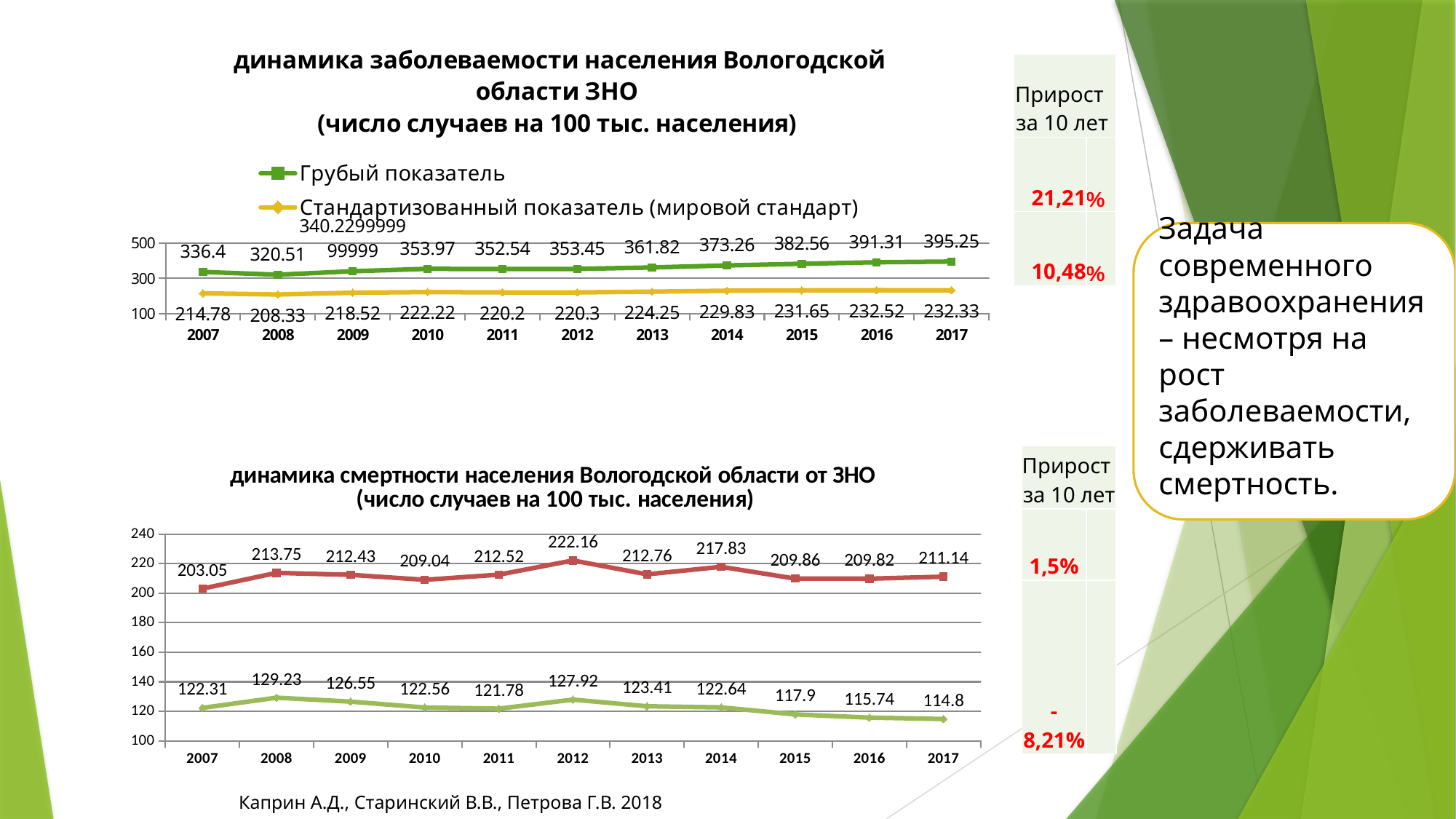
In the top chart (динамика заболеваемости), which year has the lowest value of Грубый показатель? 2008 In the top chart (динамика заболеваемости населения Вологодской области ЗНО), what is the value of Грубый показатель for 2017? 395.25 In the bottom chart (динамика смертности), what is the difference between the upper (red) line values for 2012 and 2007? 19.11 In the top chart (динамика заболеваемости), how many years are shown on the x axis? 11 In the bottom chart (динамика смертности), which year has the lowest value on the lower (green) line? 2017 In the top chart (динамика заболеваемости), what is the value of Стандартизованный показатель (мировой стандарт) for 2007? 214.78 In the bottom chart (динамика смертности), is the value of the lower (green) line for 2017 larger or smaller than its value for 2007? smaller In the bottom chart (динамика смертности), which year has the highest value on the lower (green) line? 2008 What type of chart is the bottom chart (динамика смертности населения Вологодской области от ЗНО)? line chart In the bottom chart (динамика смертности), what is the value of the upper (red) line for 2012? 222.16 In the top chart (динамика заболеваемости), how many series does the legend list? 2 In the top chart (динамика заболеваемости), what is the difference between the Грубый показатель values for 2017 and 2007? 58.85